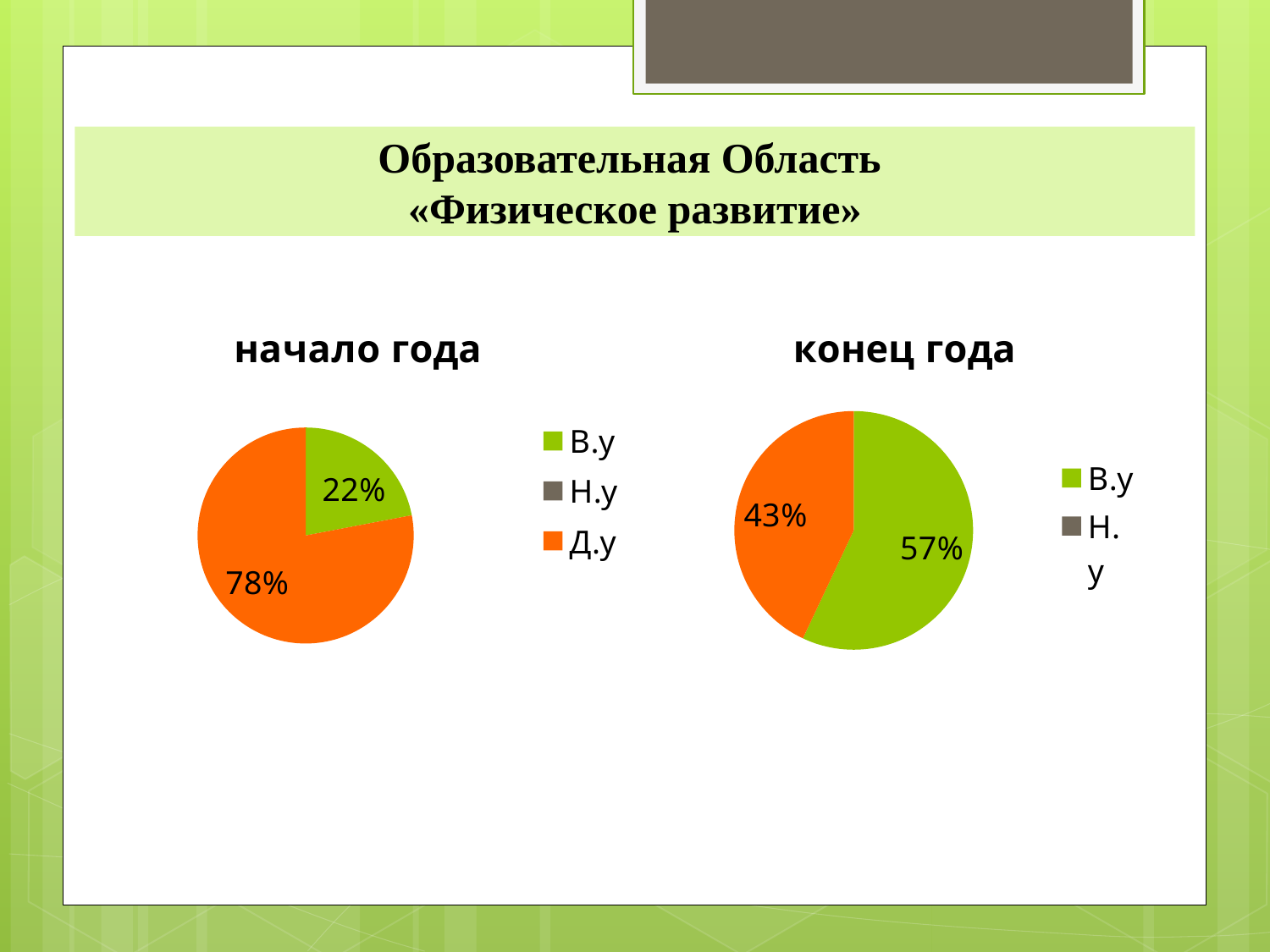
In the 'конец года' chart, what percentage is shown on the orange slice? 43% In the 'начало года' chart, what share does Д.у have? 78% What colour is the В.у slice in the 'конец года' chart? green Is the В.у share larger in the 'начало года' chart or in the 'конец года' chart? конец года In the 'начало года' chart, which labelled category has the largest slice? Д.у In the 'конец года' chart, what share does В.у have? 57% How many entries does the legend of the 'начало года' chart list? 3 In the 'начало года' chart, which labelled category has the smallest visible slice? В.у In the 'начало года' chart, what share does В.у have? 22% In the 'конец года' chart, what is the difference between the 57% slice and the 43% slice? 14% In the 'начало года' chart, what is the difference between the Д.у share and the В.у share? 56% What type of chart is used for 'начало года' and 'конец года'? pie chart